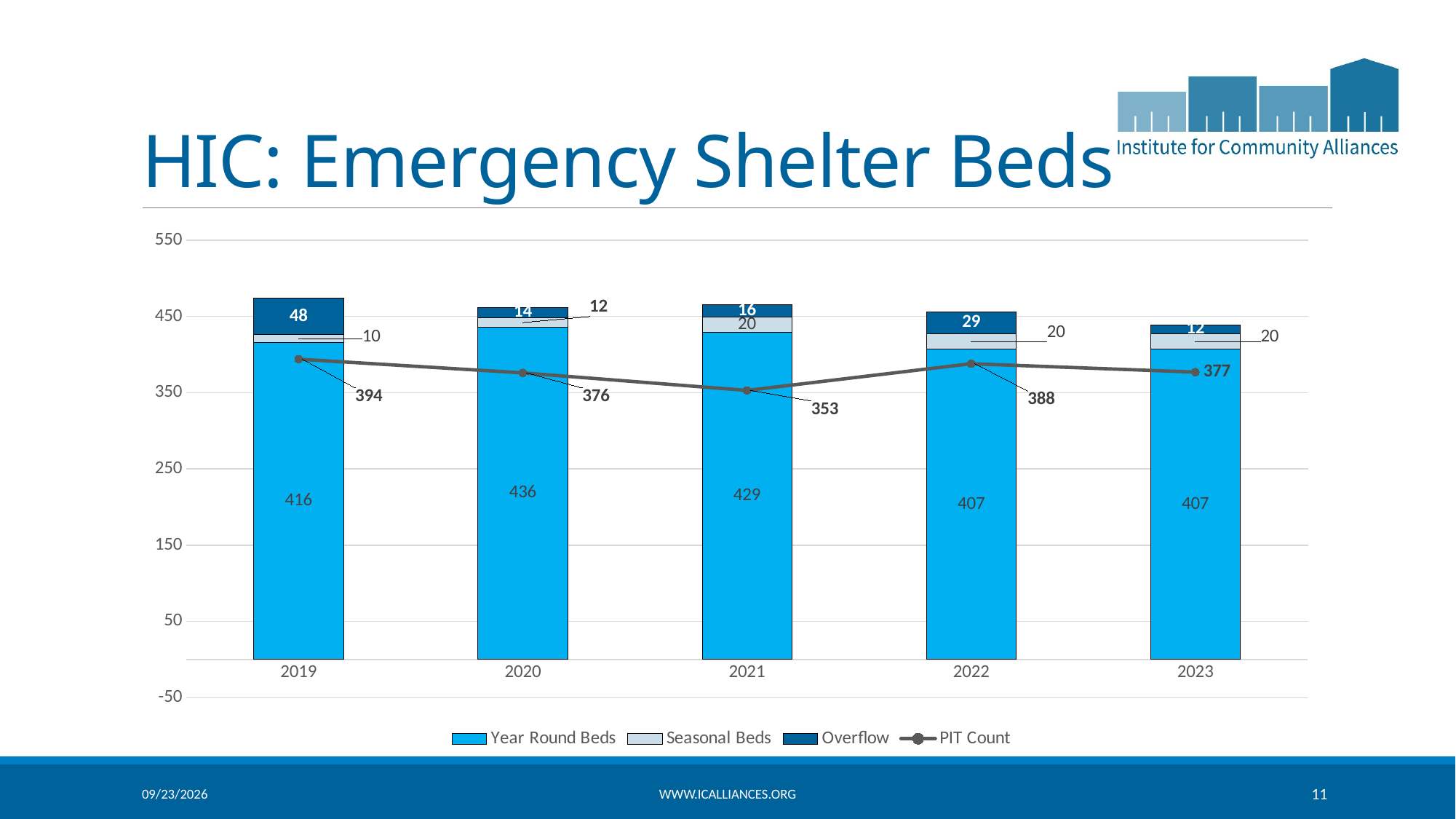
What is the difference between the PIT Count in 2022 and in 2021? 35 What is the title of the chart? HIC: Emergency Shelter Beds What is the Seasonal Beds value in 2023? 20 What is the PIT Count for 2021? 353 Which year has the highest PIT Count? 2019 What is the total of the stacked bar for 2019? 474 What is the value of Year Round Beds in 2020? 436 How many years are shown on the x axis? 5 What is the Overflow value in 2019? 48 Which is larger, Year Round Beds in 2019 or in 2021? 2021 Which year has the lowest Overflow value? 2023 How many series does the legend list? 4